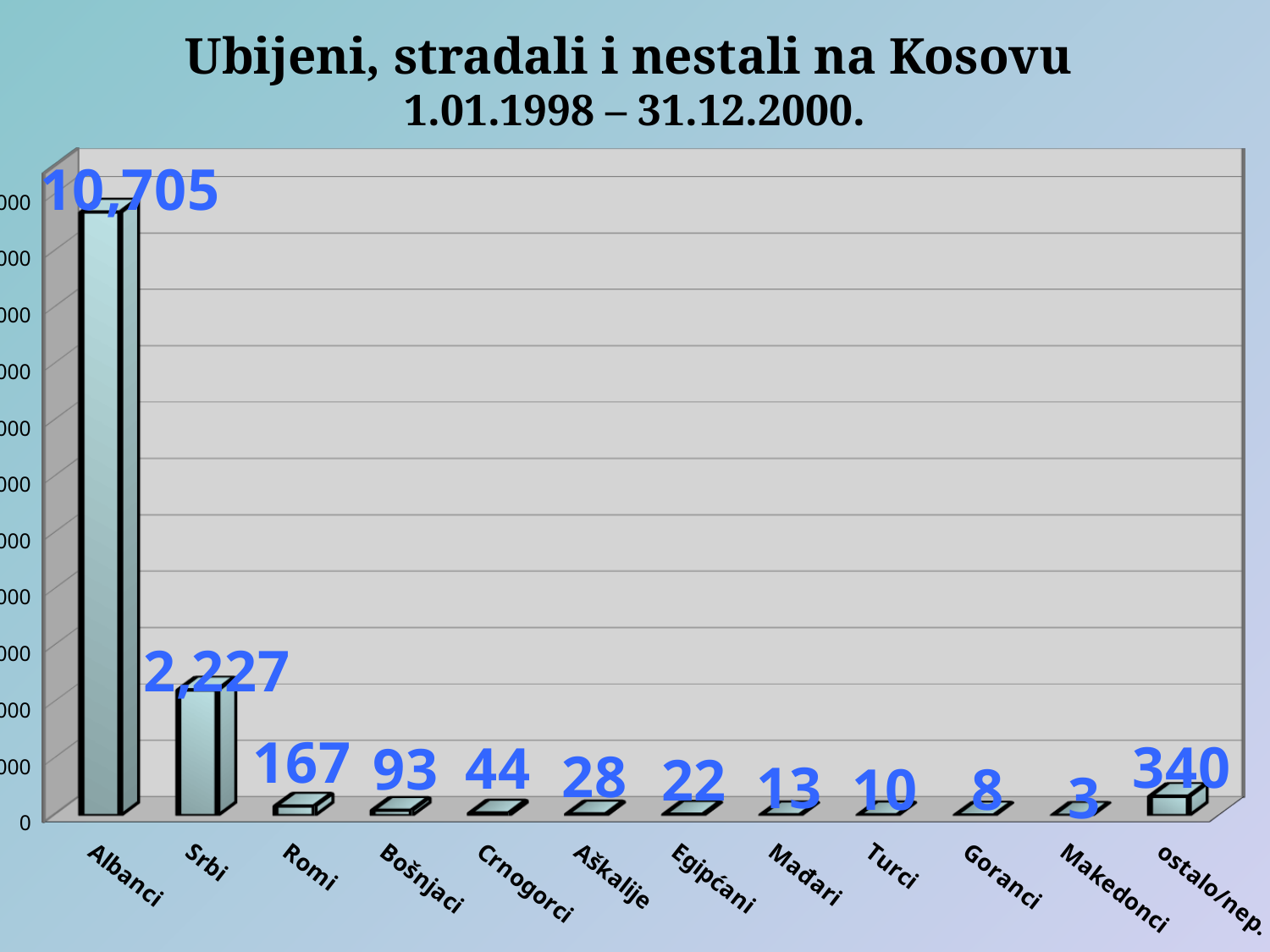
What is the value for Romi? 167 What is the title of the chart? Ubijeni, stradali i nestali na Kosovu 1.01.1998 – 31.12.2000. Which category has the highest value? Albanci What is the value for Albanci? 10,705 What is the value for Srbi? 2,227 Which category has the lowest value? Makedonci What is the value for Makedonci? 3 Which is larger, the value for Romi or the value for ostalo/nep.? ostalo/nep. What kind of chart is shown on the slide? Bar chart What is the difference between the values for Albanci and Srbi? 8,478 How many categories are shown on the x axis? 12 What is the value for ostalo/nep.? 340